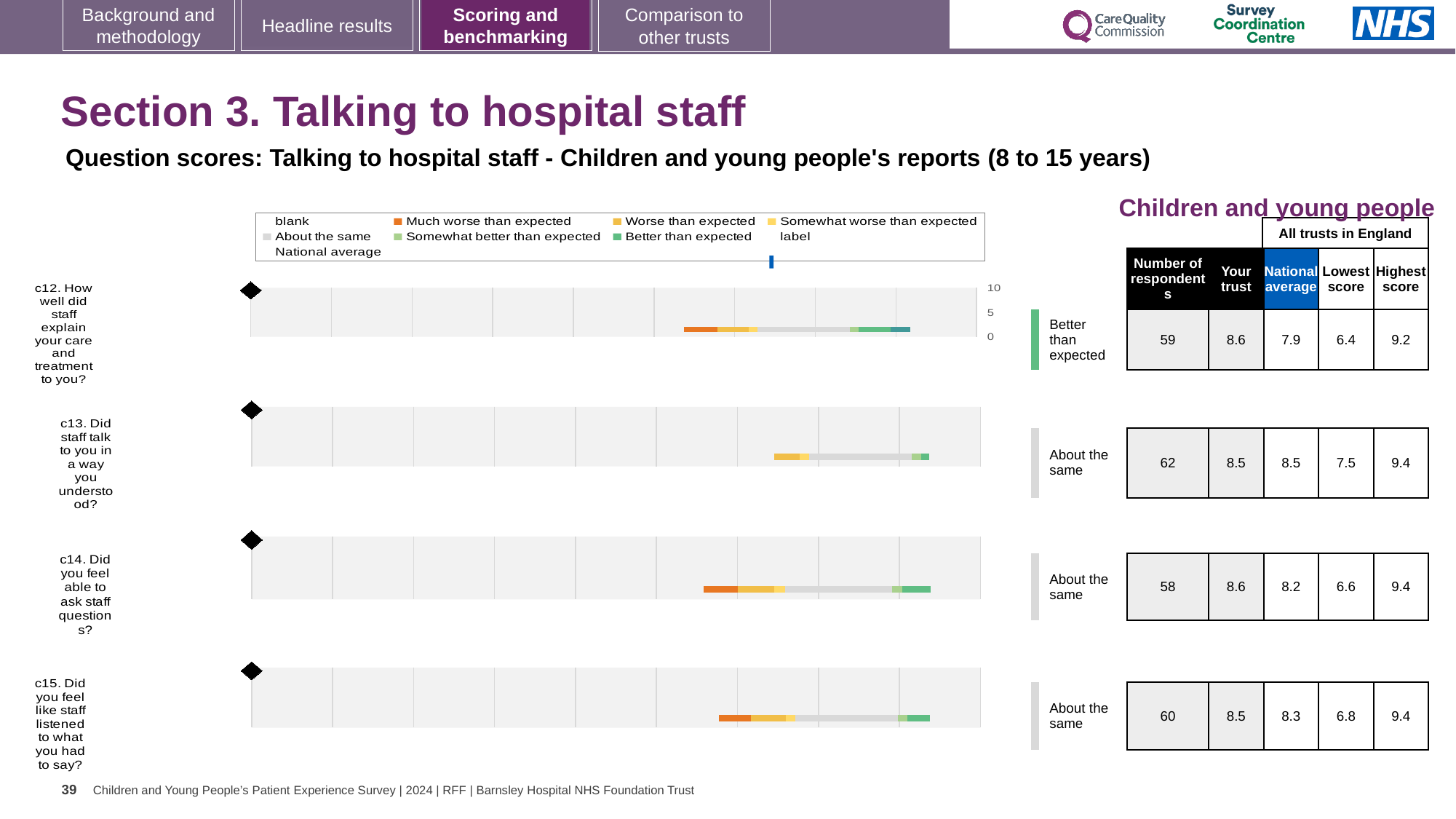
What benchmark category is shown for c13 (Did staff talk to you in a way you understood?)? About the same What is the difference between the 'Your trust' score and the national average for c12? 0.7 Which question is rated 'Better than expected' on the slide? c12 What kind of chart is used to show the question scores for c12 to c15? bar chart What is the lowest score among all trusts in England for c15 (Did you feel like staff listened to what you had to say?)? 6.8 Which question has the lowest 'Lowest score' value among all trusts in England? c12 How many entries does the chart legend list? 9 What is the 'Your trust' score for c12 (How well did staff explain your care and treatment to you?)? 8.6 How many respondents answered c13 (Did staff talk to you in a way you understood?)? 62 How many questions (c12 to c15) have a chart on the slide? 4 What is the national average score for c14 (Did you feel able to ask staff questions?)? 8.2 For c14, which is larger: the 'Your trust' score or the national average? Your trust